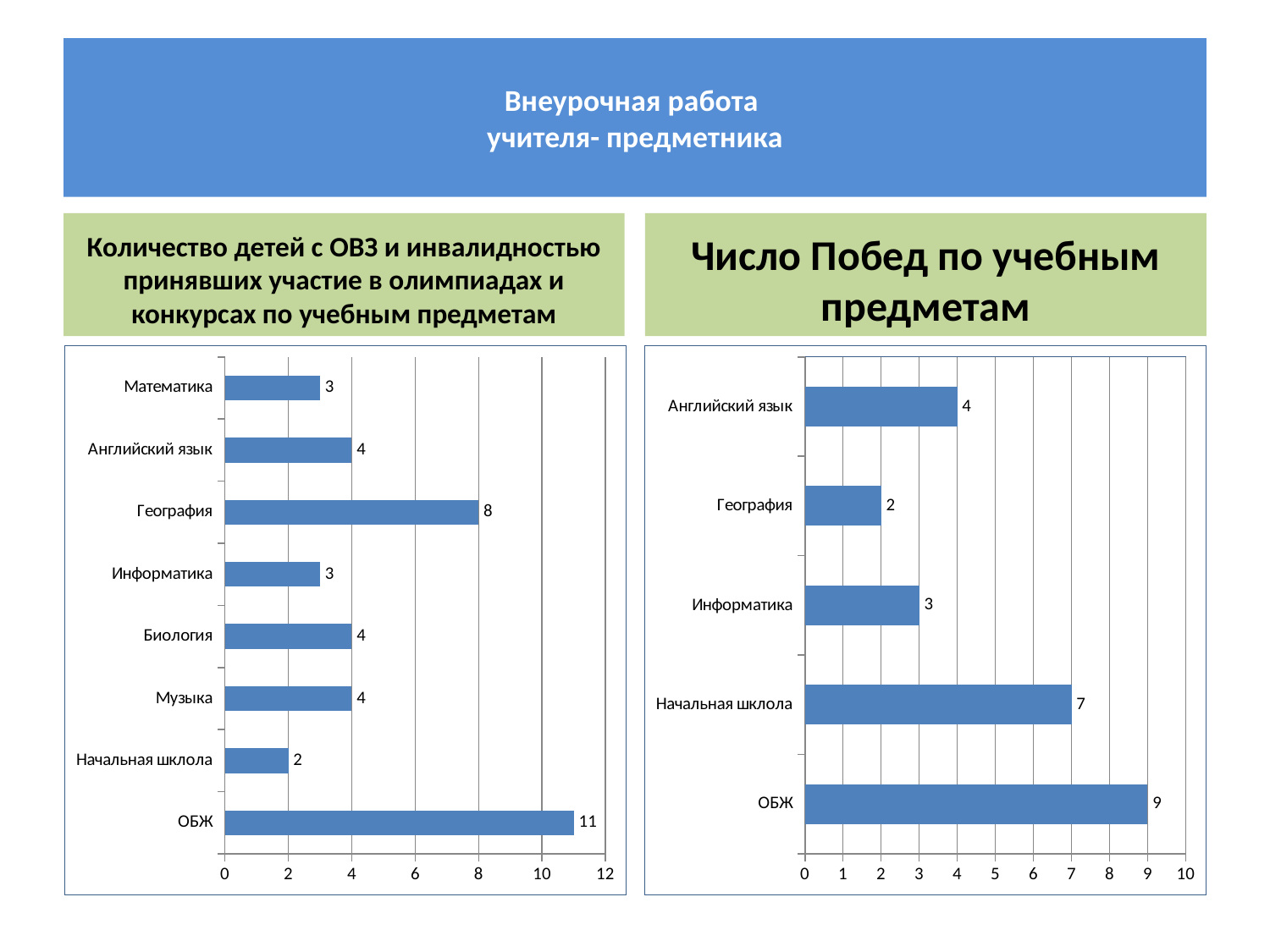
In the right chart (Число Побед по учебным предметам), how many categories are shown? 5 In the left chart (Количество детей с ОВЗ и инвалидностью...), how many categories are shown? 8 In the left chart (Количество детей с ОВЗ и инвалидностью...), which category has the lowest value? Начальная школа In the left chart (Количество детей с ОВЗ и инвалидностью...), what is the difference between ОБЖ and География? 3 In the right chart (Число Побед по учебным предметам), which category has the lowest value? География In the left chart (Количество детей с ОВЗ и инвалидностью...), what is the value for ОБЖ? 11 In the right chart (Число Побед по учебным предметам), what is the value for Начальная школа? 7 What type of chart is the right chart (Число Побед по учебным предметам)? Bar chart In the left chart (Количество детей с ОВЗ и инвалидностью...), which is larger, Математика or Английский язык? Английский язык In the right chart (Число Побед по учебным предметам), which category has the highest value? ОБЖ In the right chart (Число Побед по учебным предметам), what is the difference between ОБЖ and Информатика? 6 In the left chart (Количество детей с ОВЗ и инвалидностью...), what is the value for География? 8